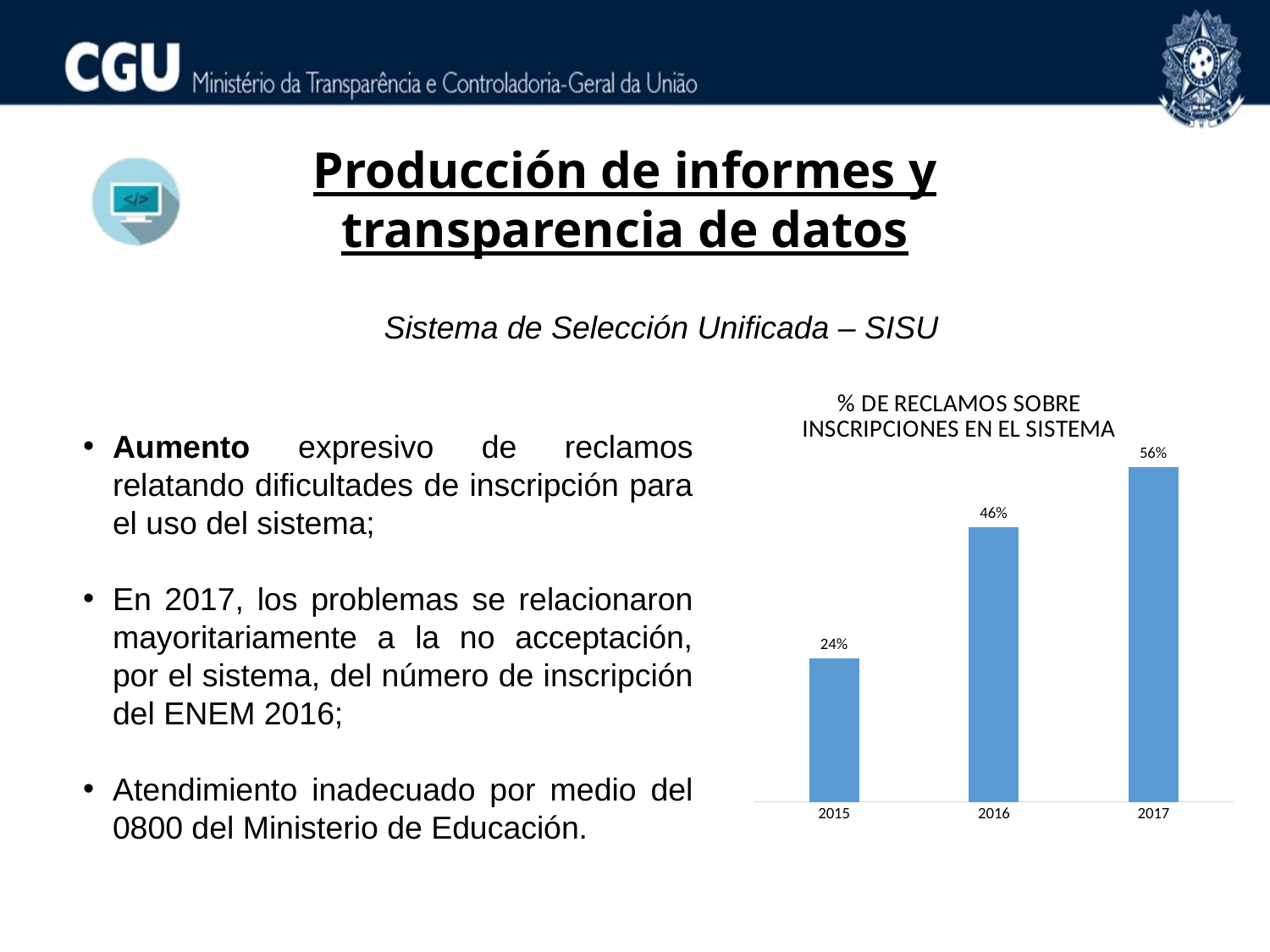
What is the difference between the values for 2016 and 2015? 22% What is the value for 2015 in the chart? 24% Do the values rise or fall from 2015 to 2017? Rise Which year has the highest value in the chart? 2017 What kind of chart is shown on the slide? Bar chart Which is larger, the value for 2016 or the value for 2017? 2017 What is the difference between the values for 2017 and 2015? 32% What is the value for 2016 in the chart? 46% How many years are shown on the x axis of the chart? 3 What is the title of the chart? % DE RECLAMOS SOBRE INSCRIPCIONES EN EL SISTEMA Which year has the lowest value in the chart? 2015 What is the value for 2017 in the chart? 56%